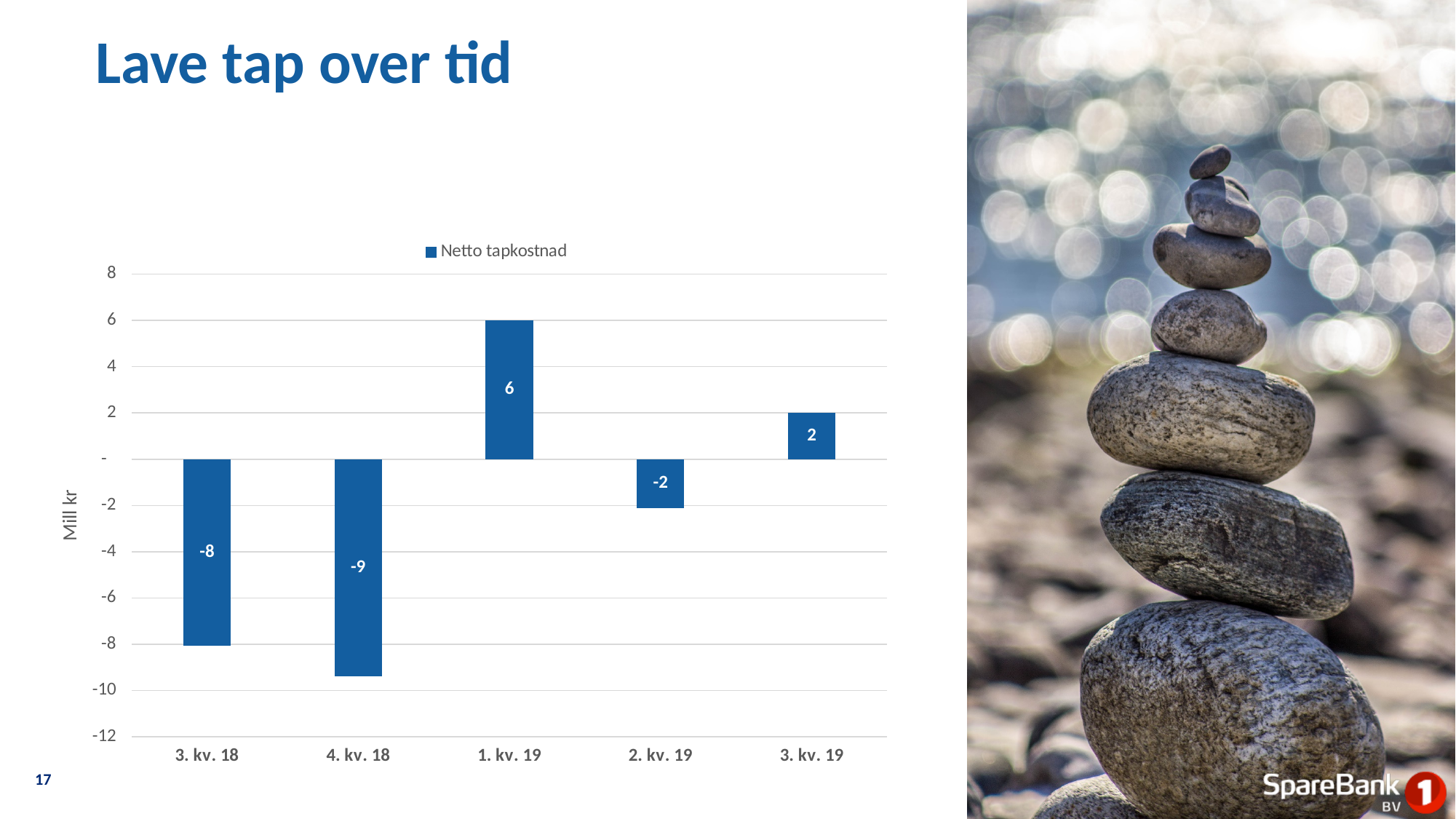
What is the value for 3. kv. 18? -8 What series name does the legend show? Netto tapkostnad What is the value for 3. kv. 19? 2 What is the value for 4. kv. 18? -9 What is the value for 2. kv. 19? -2 What is the difference between the values for 1. kv. 19 and 3. kv. 19? 4 Which quarter has the lowest value? 4. kv. 18 How many quarters are shown on the x axis? 5 What is the value for 1. kv. 19? 6 Which quarter has the highest value? 1. kv. 19 Which is larger, the value for 3. kv. 18 or the value for 2. kv. 19? 2. kv. 19 What kind of chart is shown on the slide? Bar chart